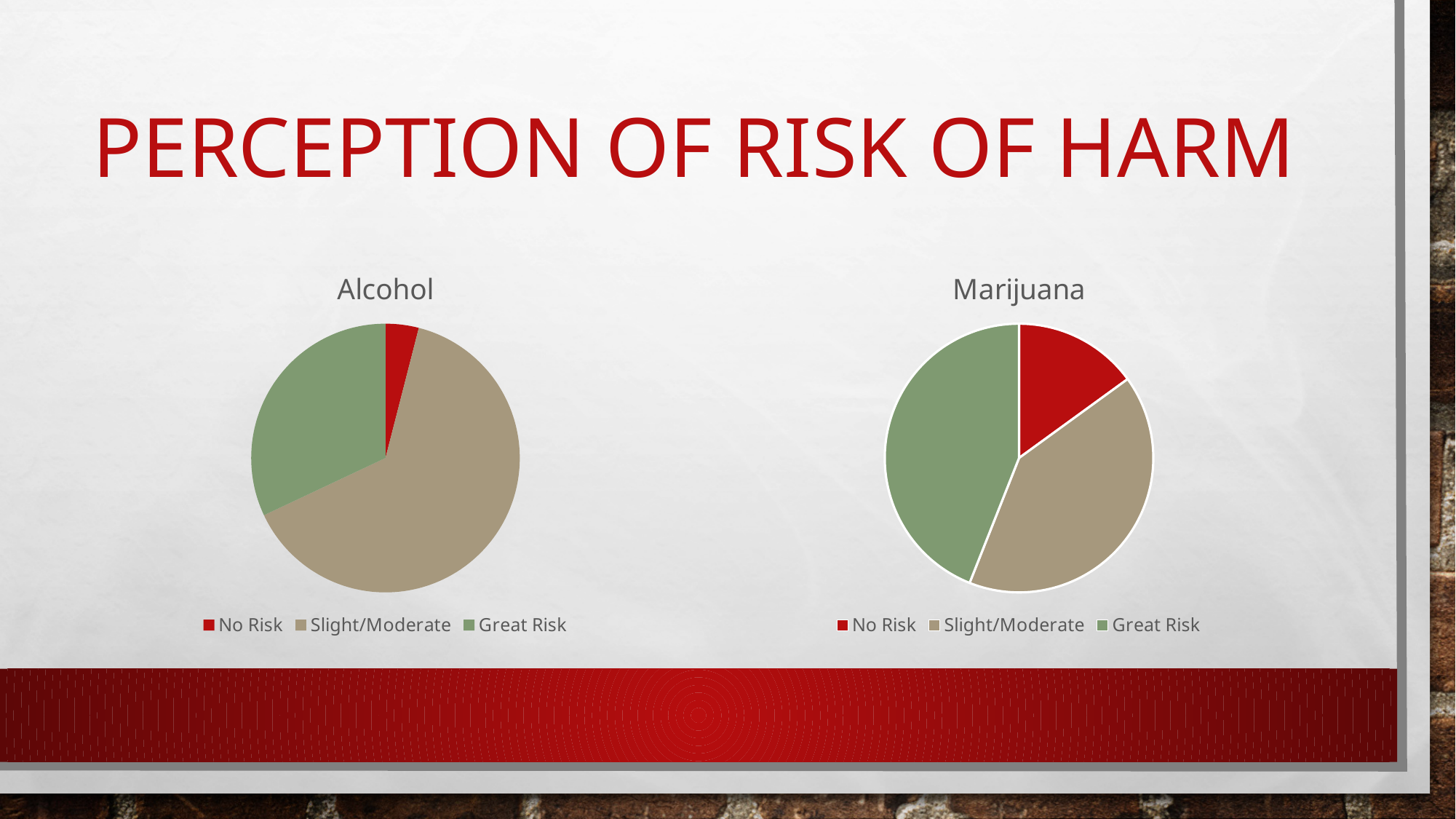
In the Alcohol chart, what colour is the Great Risk slice? green In the Alcohol chart, which slice is larger: Great Risk or No Risk? Great Risk How many entries does the legend of the Marijuana chart list? 3 In the Alcohol chart, which category has the smallest slice? No Risk How many slices does the Alcohol pie chart have? 3 In the Marijuana chart, which slice is larger: No Risk or Great Risk? Great Risk What kind of chart is the Alcohol chart? pie chart In the Alcohol chart, which category has the largest slice? Slight/Moderate In the Marijuana chart, which category has the smallest slice? No Risk What kind of chart is the Marijuana chart? pie chart Is the No Risk slice larger in the Alcohol chart or the Marijuana chart? Marijuana What is the title of the slide containing the two pie charts? PERCEPTION OF RISK OF HARM